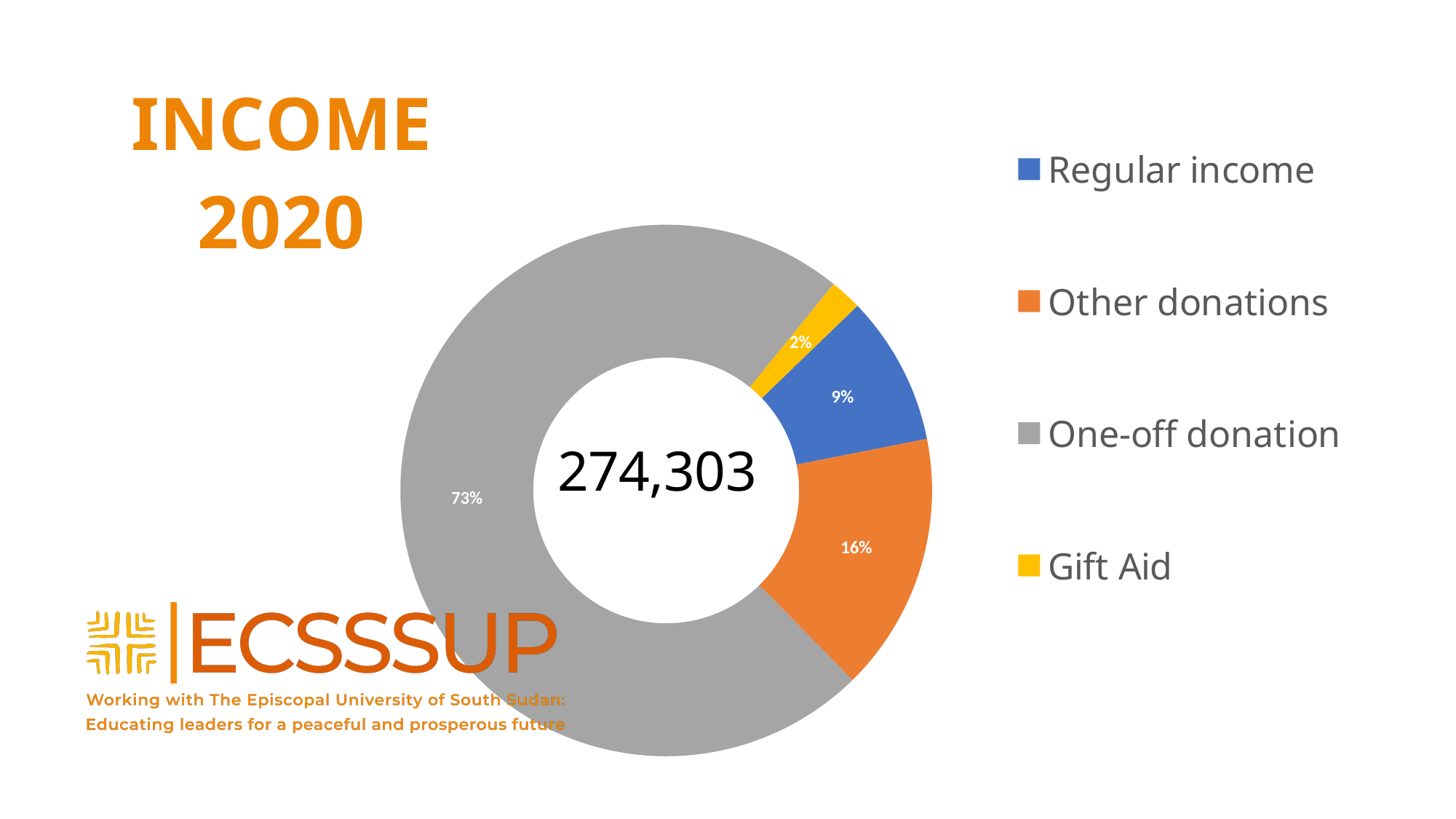
What share of income does Regular income represent? 9% What share of income does Gift Aid represent? 2% What total value is shown in the centre of the chart? 274,303 What share of income does One-off donation represent? 73% What kind of chart is shown on the slide? Doughnut (pie) chart Which category has the largest share of income? One-off donation What colour represents Gift Aid in the chart? Yellow Which category has the smallest share of income? Gift Aid How many categories does the chart show? 4 What is the difference in percentage points between One-off donation and Other donations? 57 Which is larger, the share for Regular income or the share for Other donations? Other donations